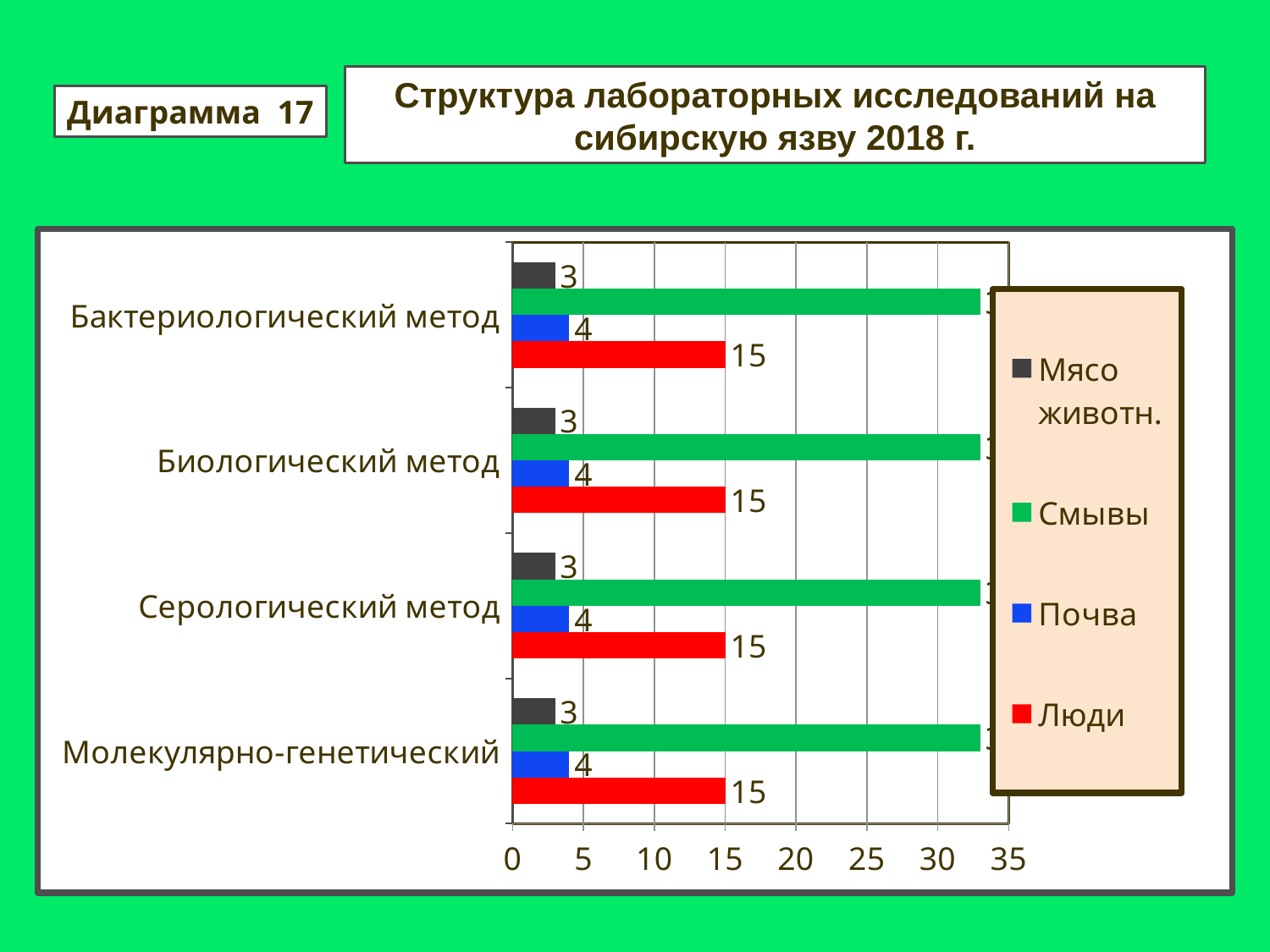
What is the title of the chart? Структура лабораторных исследований на сибирскую язву 2018 г. How many categories (methods) are shown on the chart? 4 Which series has the highest value in the Биологический метод category? Смывы Which is larger in the Биологический метод category: Почва or Мясо животн.? Почва Which series has the lowest value in the Бактериологический метод category? Мясо животн. How many series does the legend list? 4 What is the value for Люди in the Бактериологический метод category? 15 What is the value for Почва in the Серологический метод category? 4 What is the value for Мясо животн. in the Молекулярно-генетический category? 3 What kind of chart is shown on the slide? bar chart What is the difference between the Люди and Почва values in the Серологический метод category? 11 Is the value for Смывы in the Молекулярно-генетический category greater or less than 30? greater